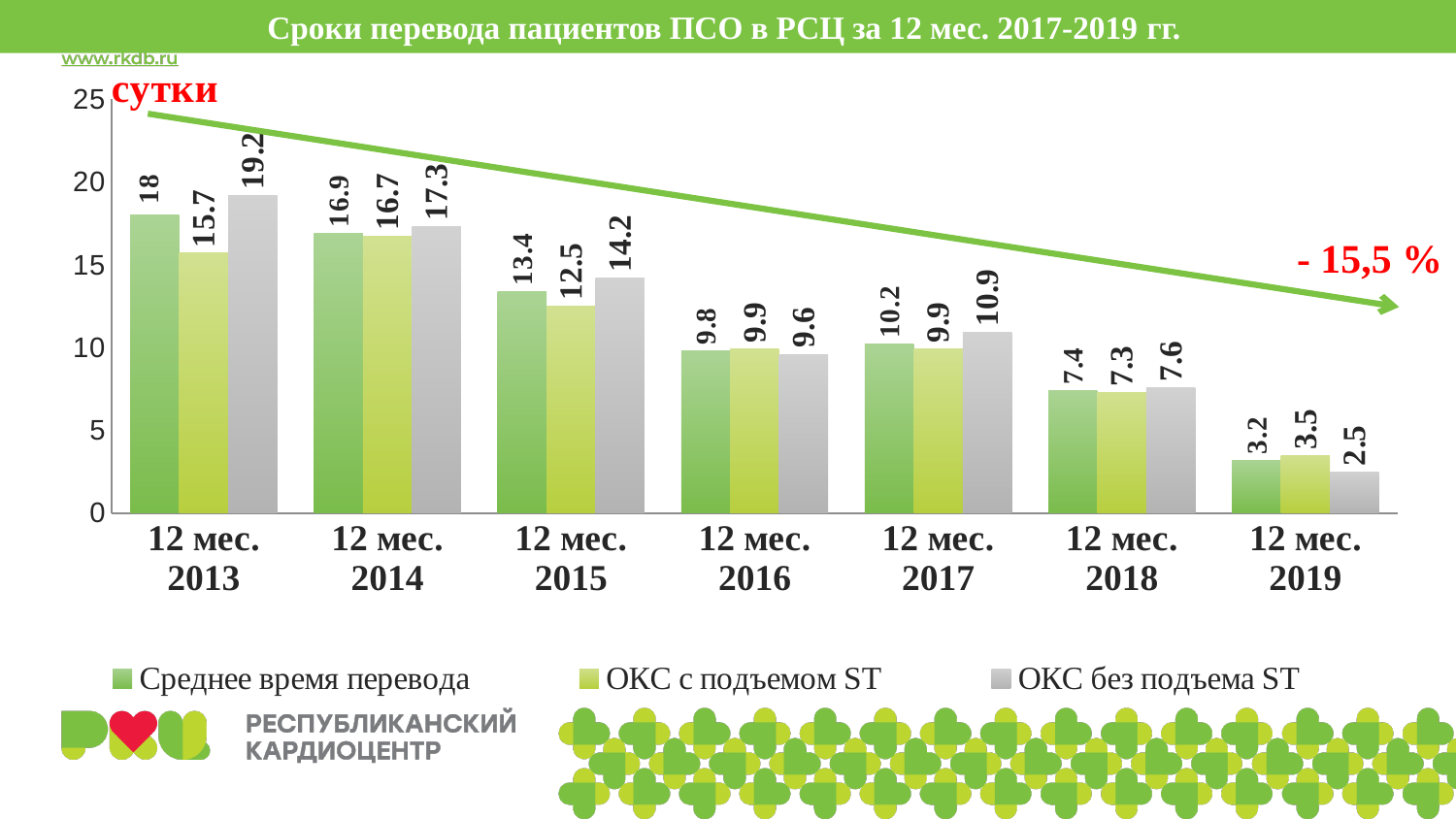
In which period is the "Среднее время перевода" value lowest? 12 мес. 2019 What is the value of "ОКС с подъемом ST" for 12 мес. 2015? 12.5 Do the "Среднее время перевода" values generally rise or fall from 2013 to 2019? fall In which period is the "ОКС без подъема ST" value highest? 12 мес. 2013 What is the difference between the "ОКС без подъема ST" value for 12 мес. 2013 and for 12 мес. 2014? 1.9 How many series does the legend list? 3 How many periods (categories) are shown on the x axis? 7 What is the value of "Среднее время перевода" for 12 мес. 2013? 18 Which is larger: "ОКС с подъемом ST" for 12 мес. 2014 or "ОКС с подъемом ST" for 12 мес. 2015? 12 мес. 2014 What kind of chart is shown on the slide? bar chart What percentage change is written in red next to the arrow on the chart? - 15,5 % What is the value of "ОКС без подъема ST" for 12 мес. 2019? 2.5